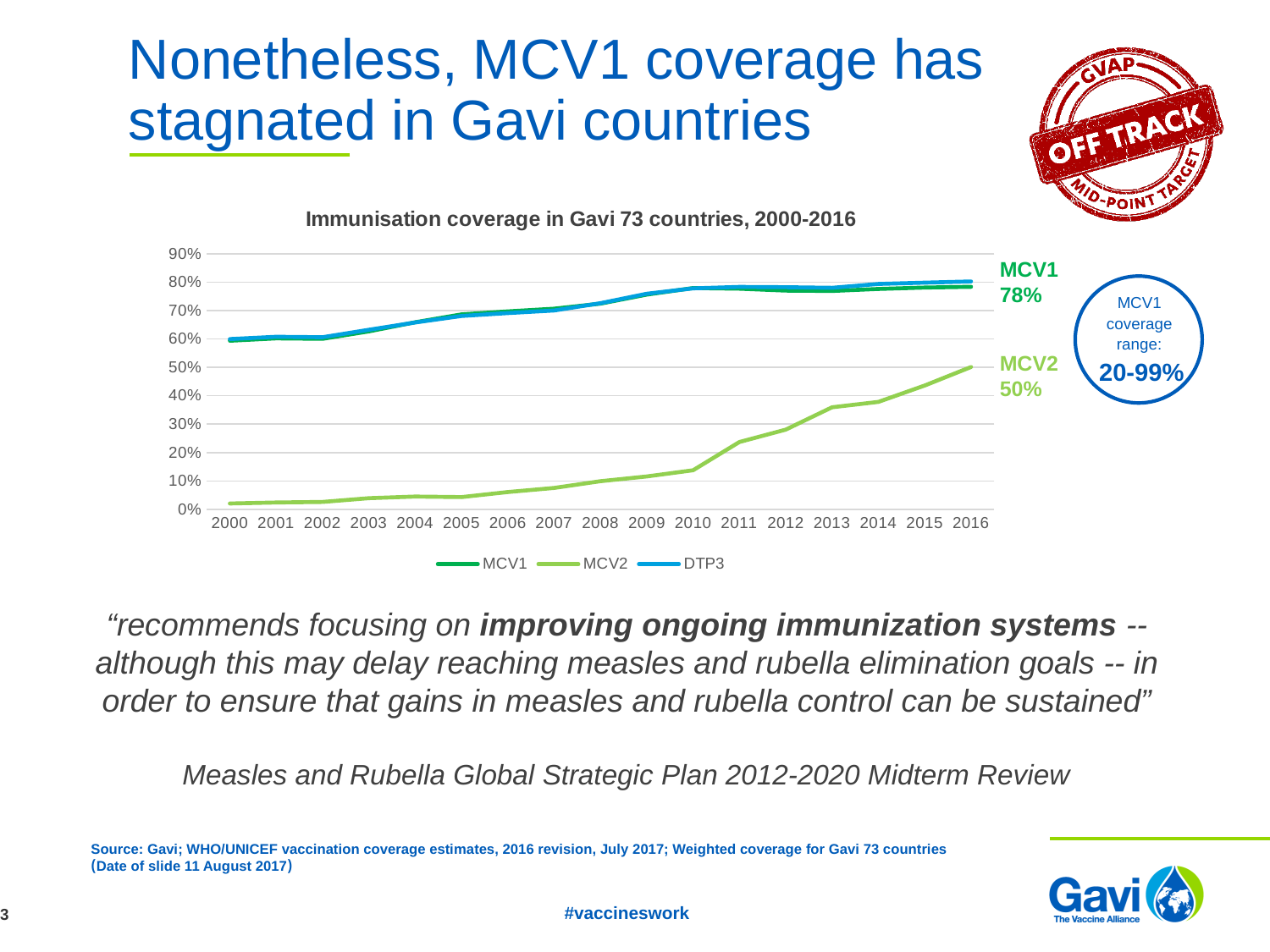
What is the difference between the labelled MCV1 and MCV2 values in 2016? 28 percentage points What is the title of the chart? Immunisation coverage in Gavi 73 countries, 2000-2016 Which series has the higher labelled value in 2016, MCV1 or MCV2? MCV1 Is the MCV1 value in 2000 greater or less than 50%? greater Is the MCV2 value in 2000 greater or less than 10%? less Which series are listed in the chart legend? MCV1, MCV2, DTP3 What is the MCV2 coverage value labelled at the end of the line in 2016? 50% How many years are shown along the x axis of the chart? 17 Does the MCV2 line rise or fall from 2000 to 2016? Rise How many series does the chart legend list? 3 What kind of chart is shown on the slide? Line chart What is the MCV1 coverage value labelled at the end of the line in 2016? 78%